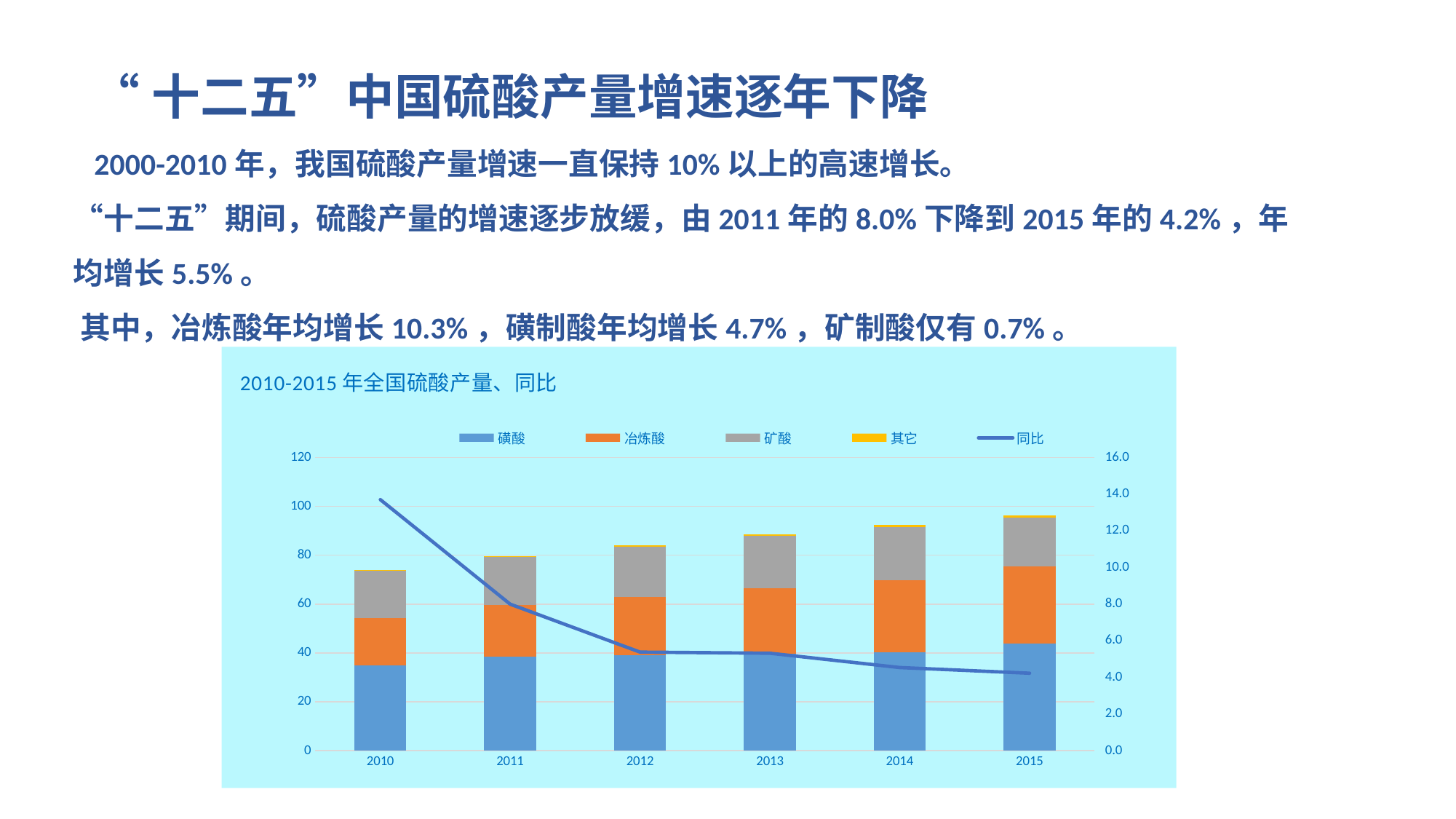
Is the total stacked bar for 2015 greater or less than 80? greater Is the 同比 value for 2015 greater or less than 6.0 on the right axis? less Does the 同比 line rise or fall from 2010 to 2015? fall Is the 同比 value for 2010 greater or less than 12.0 on the right axis? greater Which year has the tallest stacked bar in the chart? 2015 How many years are shown along the x axis of the chart? 6 How many series does the chart's legend list? 5 Which year has the shortest stacked bar in the chart? 2010 What kind of chart is shown on the slide? A stacked bar chart combined with a line chart Which series is shown in orange in the chart's legend? 冶炼酸 What is the title of the chart on the slide? 2010-2015年全国硫酸产量、同比